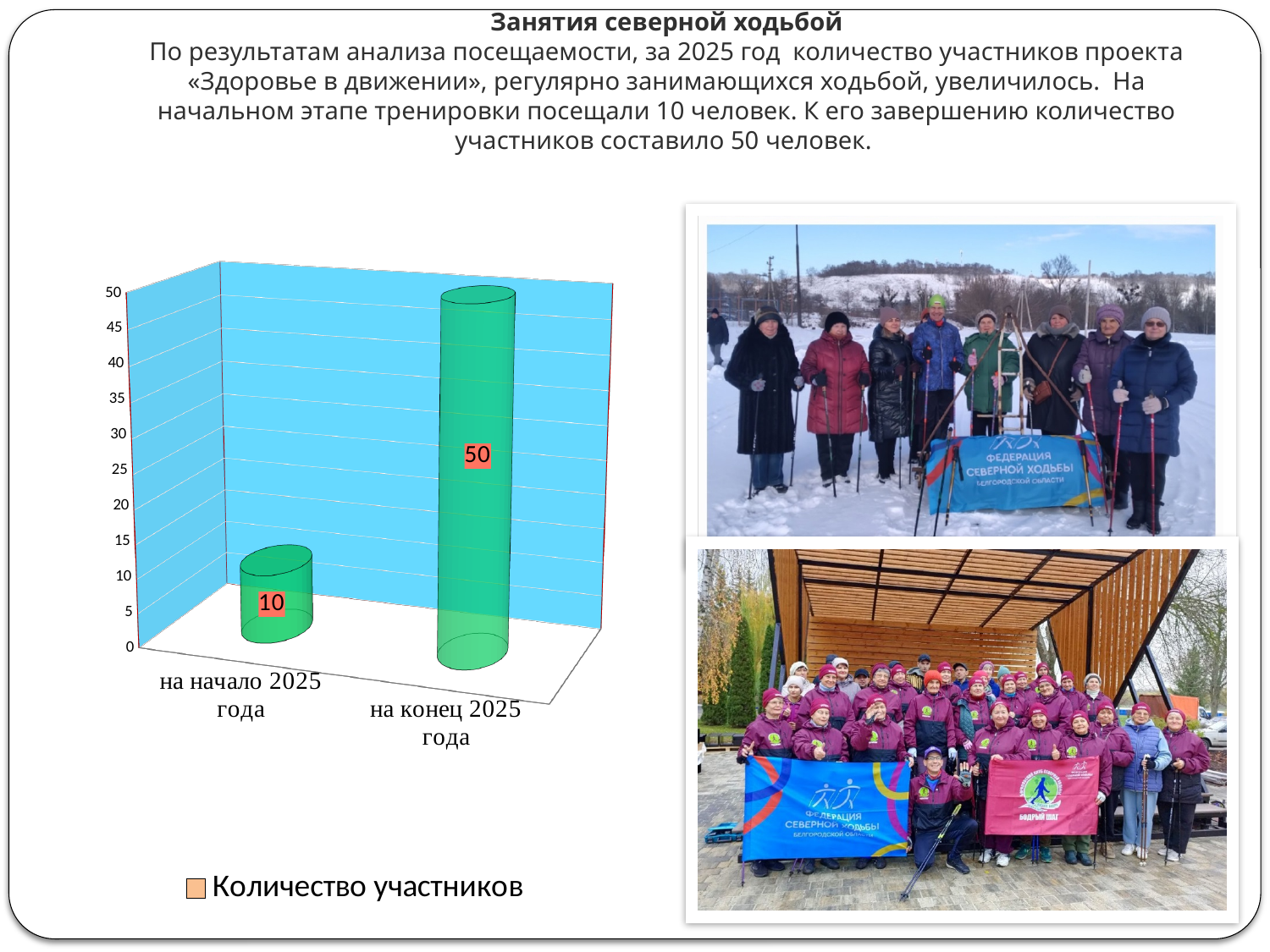
Is the value for "на начало 2025 года" greater or less than 20? less How many categories are shown on the chart? 2 Is the value for "на конец 2025 года" greater or less than 30? greater What kind of chart is shown on the slide? bar chart Which category has the lowest value? на начало 2025 года Which is larger: the value for "на начало 2025 года" or the value for "на конец 2025 года"? на конец 2025 года What is the name of the series in the chart legend? Количество участников What is the value for "на начало 2025 года"? 10 What is the value for "на конец 2025 года"? 50 How many series does the chart legend list? 1 What is the difference between the value for "на конец 2025 года" and the value for "на начало 2025 года"? 40 Which category has the highest value? на конец 2025 года